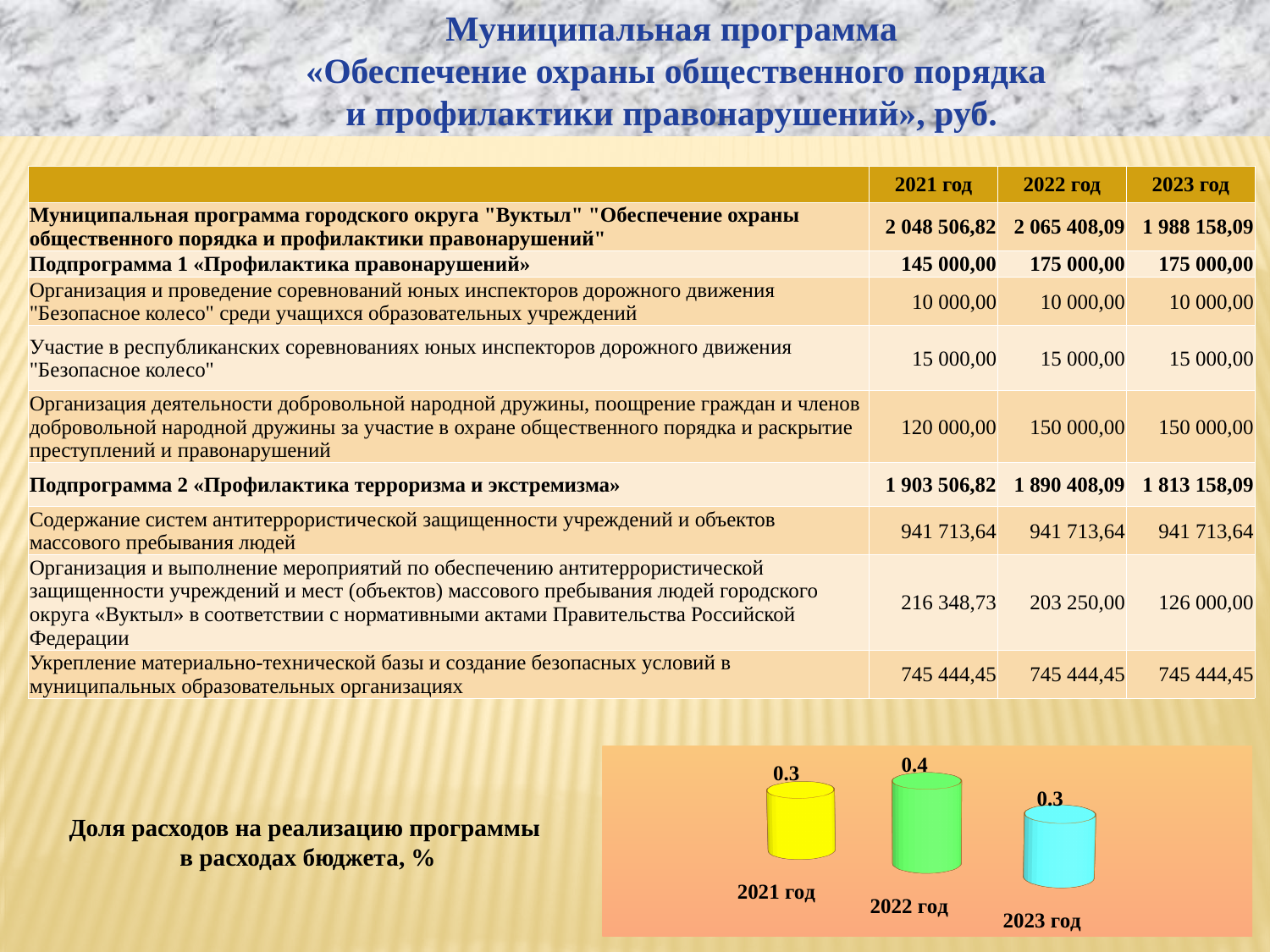
What is the value shown for 2023 год in the chart? 0.3 What kind of chart is shown at the bottom of the slide? Bar chart What is the value shown for 2021 год in the chart? 0.3 What does the chart at the bottom of the slide show, according to the text next to it? Доля расходов на реализацию программы в расходах бюджета, % Which is larger in the chart, the value for 2022 год or the value for 2023 год? 2022 год Does the value in the chart rise or fall from 2022 год to 2023 год? Fall What colour is the bar for 2022 год in the chart? Green What is the difference between the values for 2022 год and 2021 год in the chart? 0.1 How many years (categories) are shown in the chart? 3 What is the value shown for 2022 год in the chart? 0.4 Which year has the highest value in the chart? 2022 год